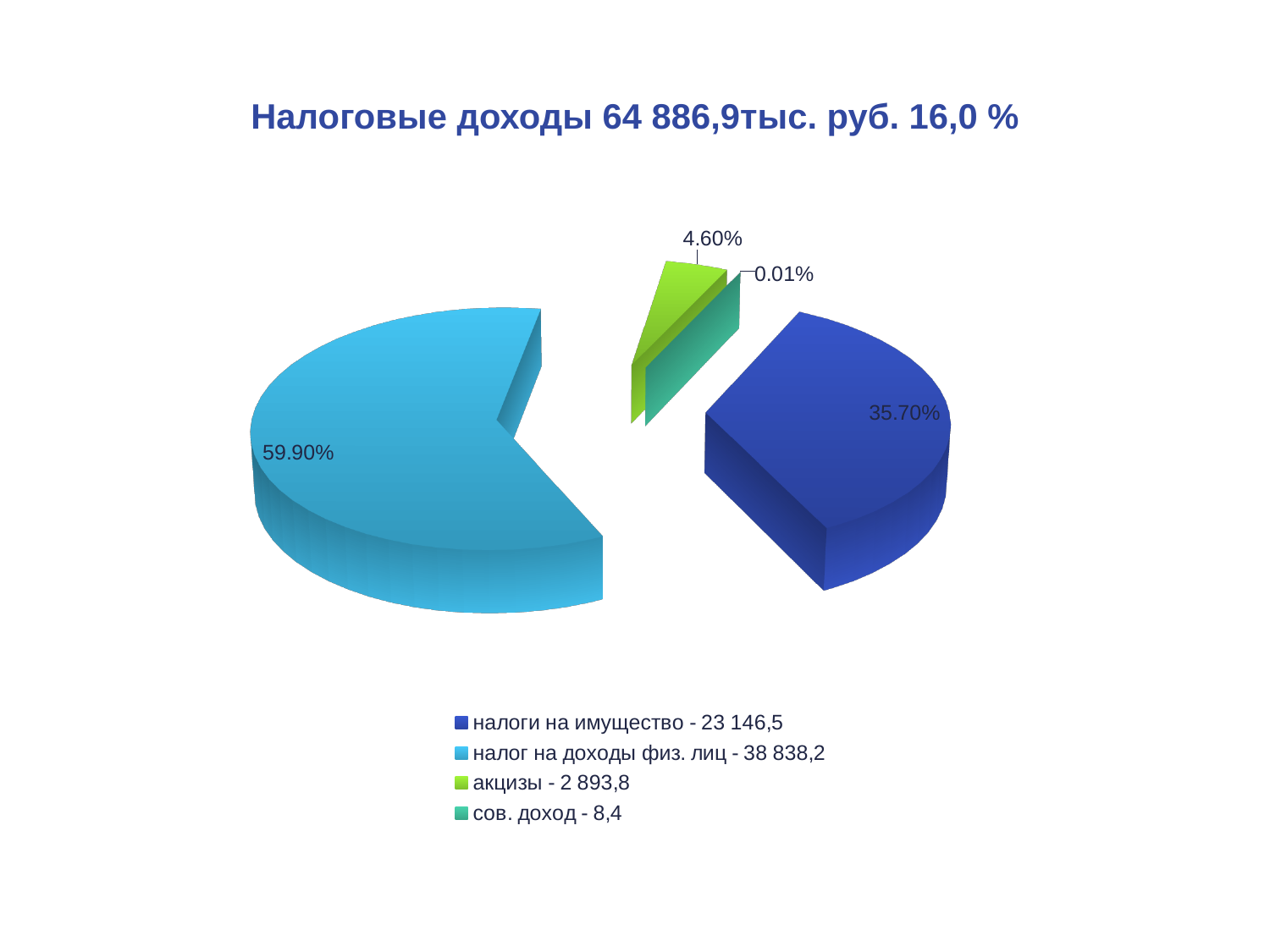
Which legend entry is shown in green? акцизы - 2 893,8 Which slice is the smallest? сов. доход - 8,4 What kind of chart is shown on the slide? pie chart How many slices does the pie chart have? 4 What share of the pie does 'налог на доходы физ. лиц - 38 838,2' have? 59.90% What share of the pie does 'сов. доход - 8,4' have? 0.01% Which is larger: the share for 'налоги на имущество - 23 146,5' or the share for 'акцизы - 2 893,8'? налоги на имущество - 23 146,5 What is the difference in percentage points between the share for 'налог на доходы физ. лиц - 38 838,2' and the share for 'налоги на имущество - 23 146,5'? 24.20% What share of the pie does 'налоги на имущество - 23 146,5' have? 35.70% What is the title of the chart? Налоговые доходы 64 886,9тыс. руб. 16,0 % Which slice is the largest? налог на доходы физ. лиц - 38 838,2